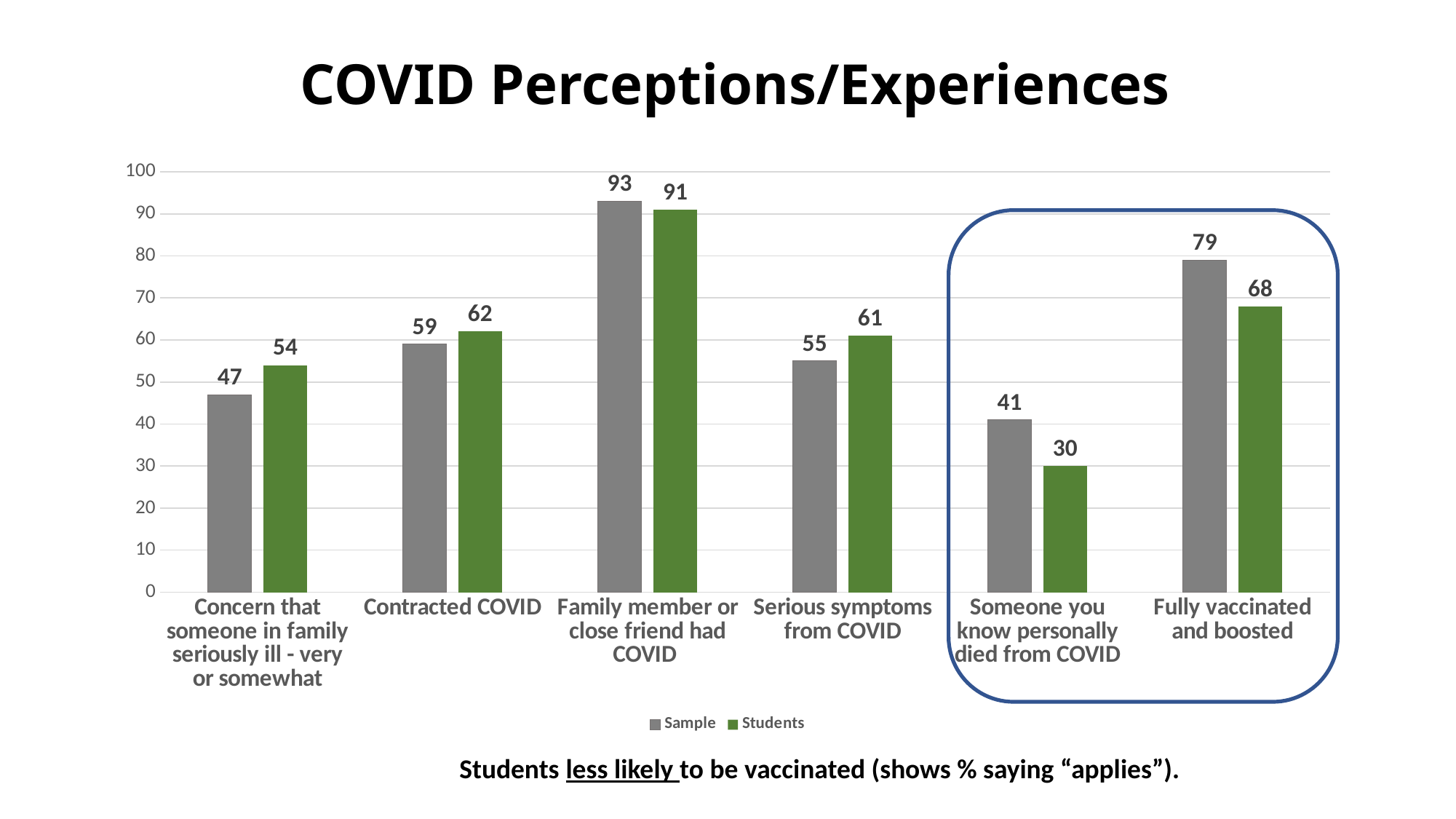
What is the difference between the Sample and Students values for "Fully vaccinated and boosted"? 11 What kind of chart is shown on the slide? Bar chart Which category has the lowest Students value? Someone you know personally died from COVID Which category has the highest Sample value? Family member or close friend had COVID What is the title of the chart? COVID Perceptions/Experiences How many categories are shown on the x axis? 6 What is the Sample value for "Fully vaccinated and boosted"? 79 What is the Students value for "Someone you know personally died from COVID"? 30 What is the Students value for "Contracted COVID"? 62 What is the difference between the Students and Sample values for "Concern that someone in family seriously ill - very or somewhat"? 7 How many series does the legend list? 2 For "Serious symptoms from COVID", which is larger, the Sample value or the Students value? Students